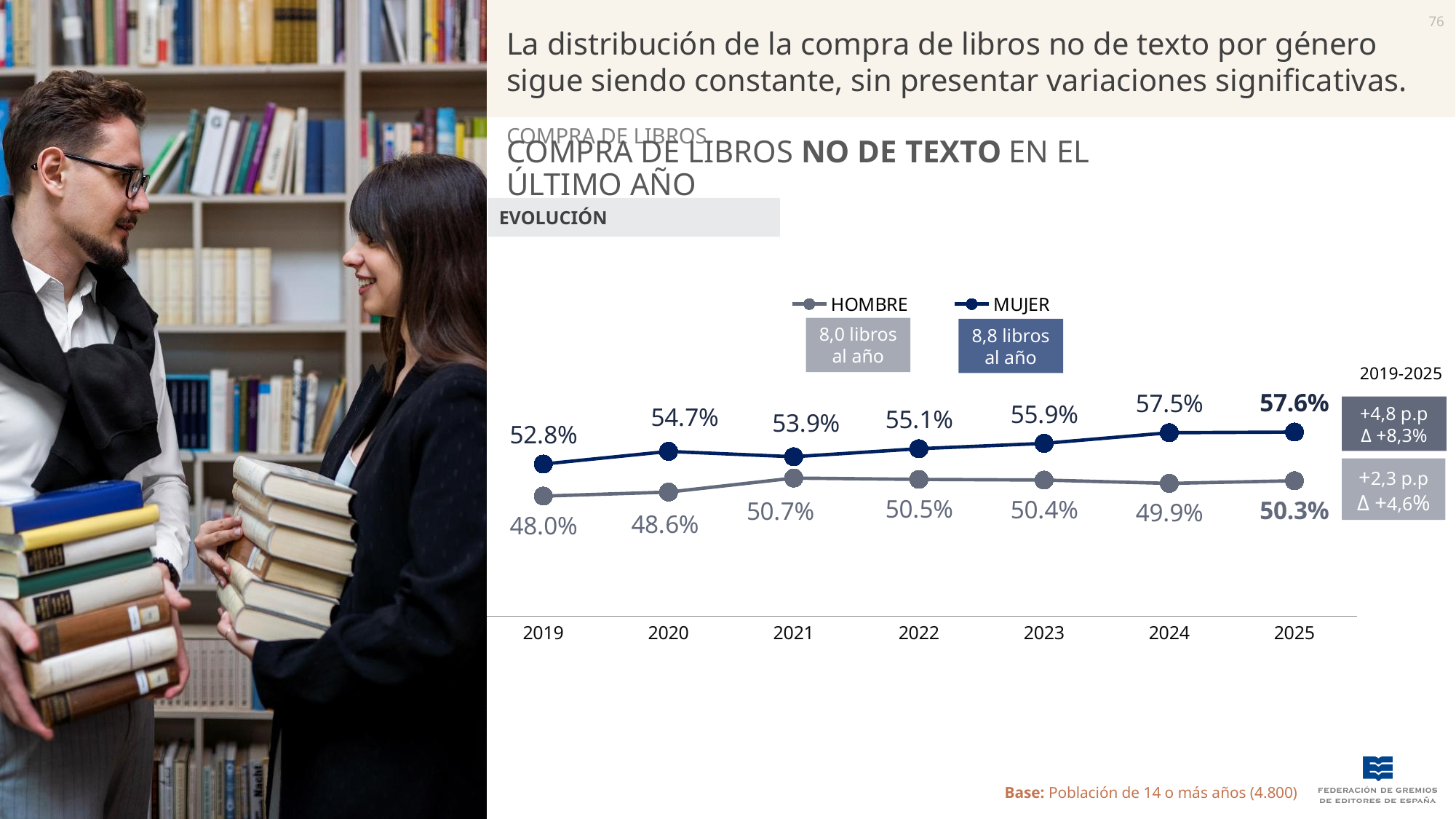
What is the value for HOMBRE in 2025? 50.3% What is the value for MUJER in 2023? 55.9% What is the value for HOMBRE in 2021? 50.7% How many series does the legend list? 2 How many years are shown on the x axis? 7 In which year is the MUJER series highest? 2025 What is the difference between the MUJER and HOMBRE values in 2025? 7.3 percentage points Does the MUJER series rise or fall from 2019 to 2025 overall? Rise What is the value for MUJER in 2019? 52.8% In which year is the HOMBRE series lowest? 2019 What kind of chart is shown on the slide? Line chart Which series has the larger value in 2022, HOMBRE or MUJER? MUJER